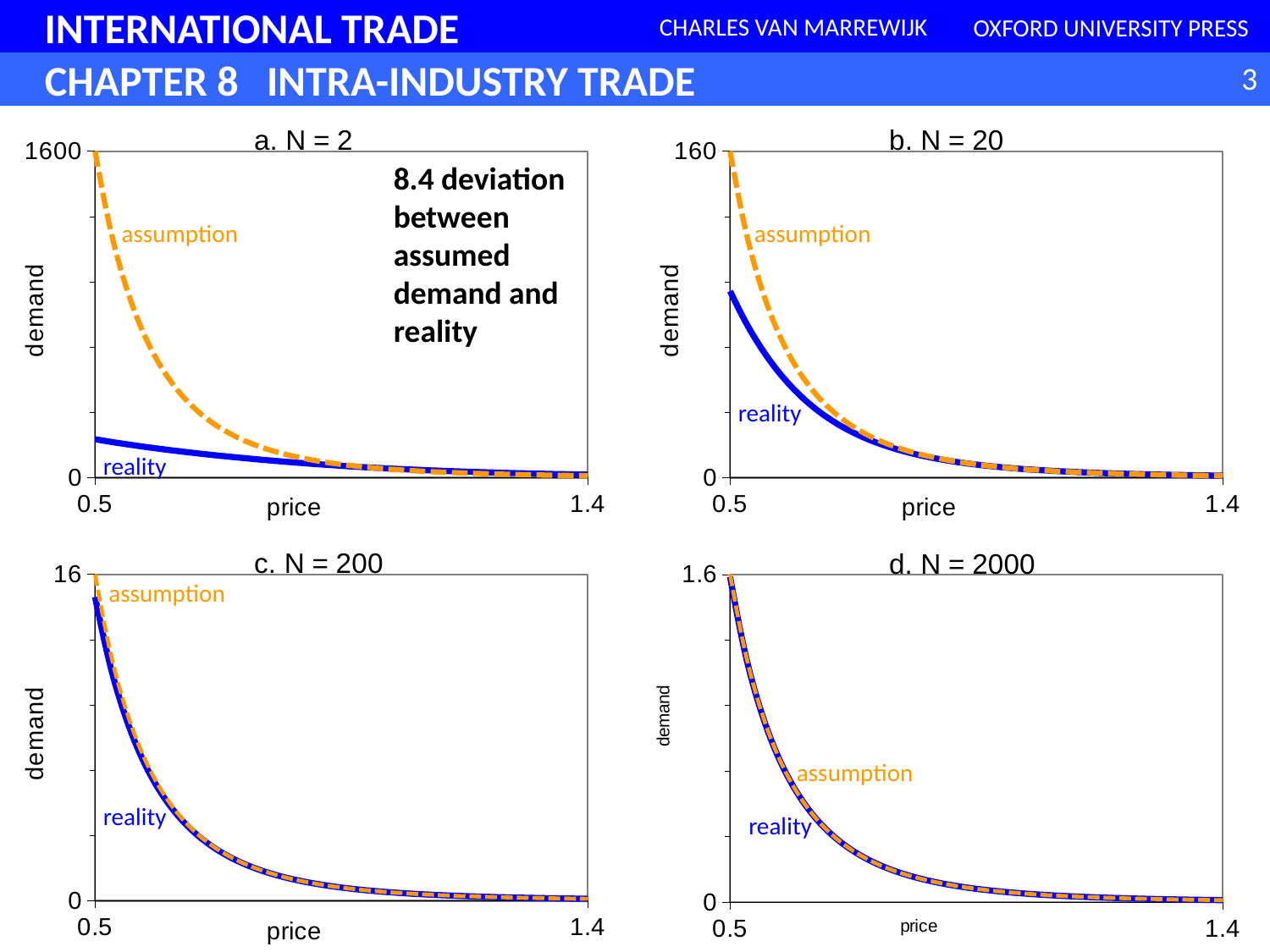
In the chart titled d. N = 2000, which series is drawn as a dashed line, assumption or reality? assumption What is the maximum value shown on the demand axis of the chart titled a. N = 2? 1600 In the chart titled c. N = 200, does the reality curve rise or fall along the price axis? fall How many series are plotted in the chart titled b. N = 20? 2 What is the label of the x axis in the chart titled b. N = 20? price In the chart titled b. N = 20, which series has the lower demand at a price of 0.5, assumption or reality? reality What kind of chart is shown in panel a. N = 2? line chart In the chart titled a. N = 2, does the assumption curve rise or fall as price increases? fall In the chart titled a. N = 2, which series has the higher demand at a price of 0.5, assumption or reality? assumption How many charts are shown on the slide? 4 In the chart titled a. N = 2, is the demand for the reality series at a price of 0.5 greater or less than 1600? less